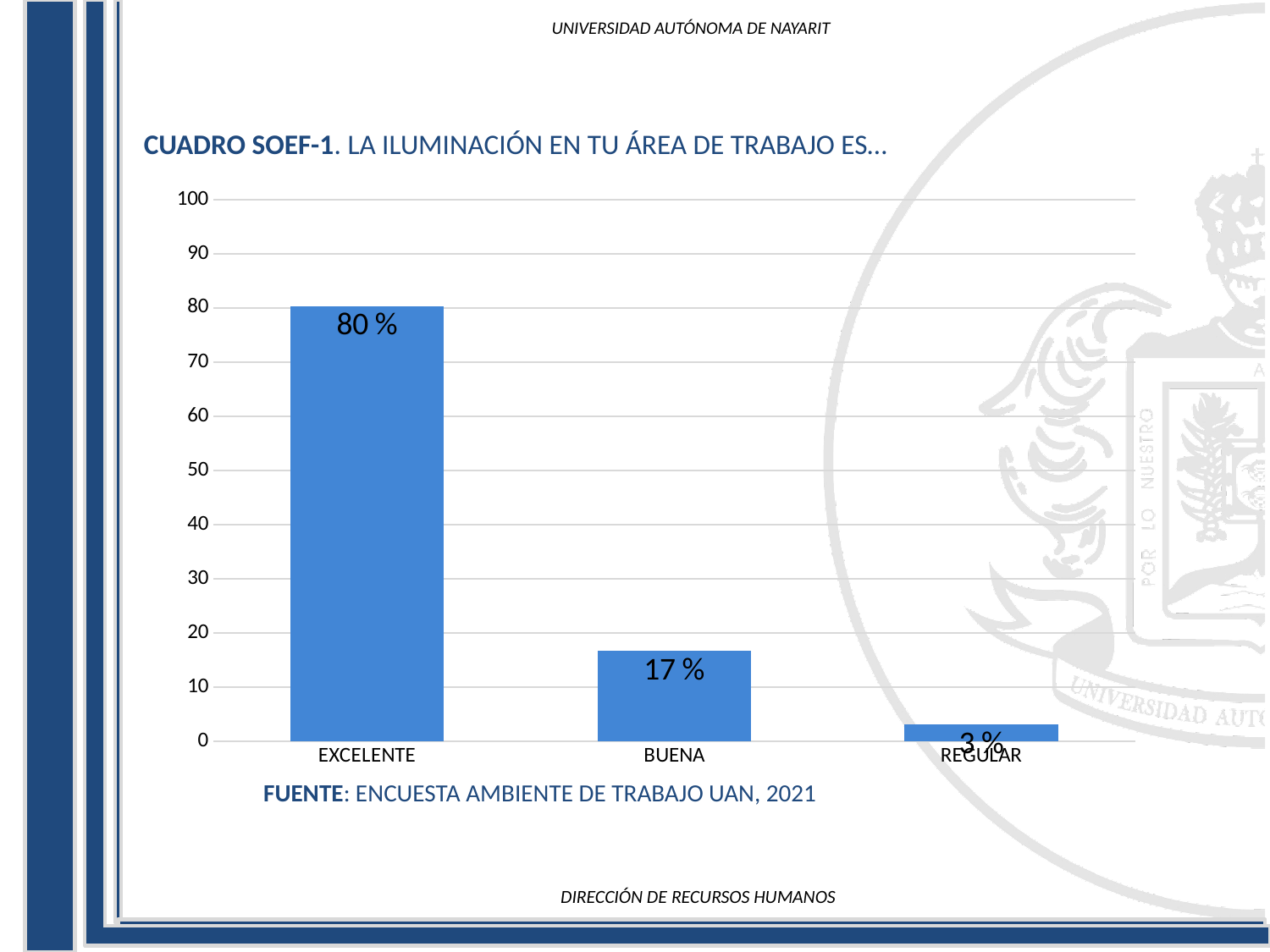
What is the value for BUENA? 17 % Which is larger, the value for BUENA or the value for REGULAR? BUENA What is the difference between the values for BUENA and REGULAR? 14 % What is the value for REGULAR? 3 % What is the difference between the values for EXCELENTE and BUENA? 63 % What kind of chart is shown on the slide? bar chart How many categories are shown on the x axis? 3 What is the source cited below the chart? ENCUESTA AMBIENTE DE TRABAJO UAN, 2021 Which category has the highest value? EXCELENTE Which category has the lowest value? REGULAR Is the value for BUENA greater or less than 20? less What is the value for EXCELENTE? 80 %